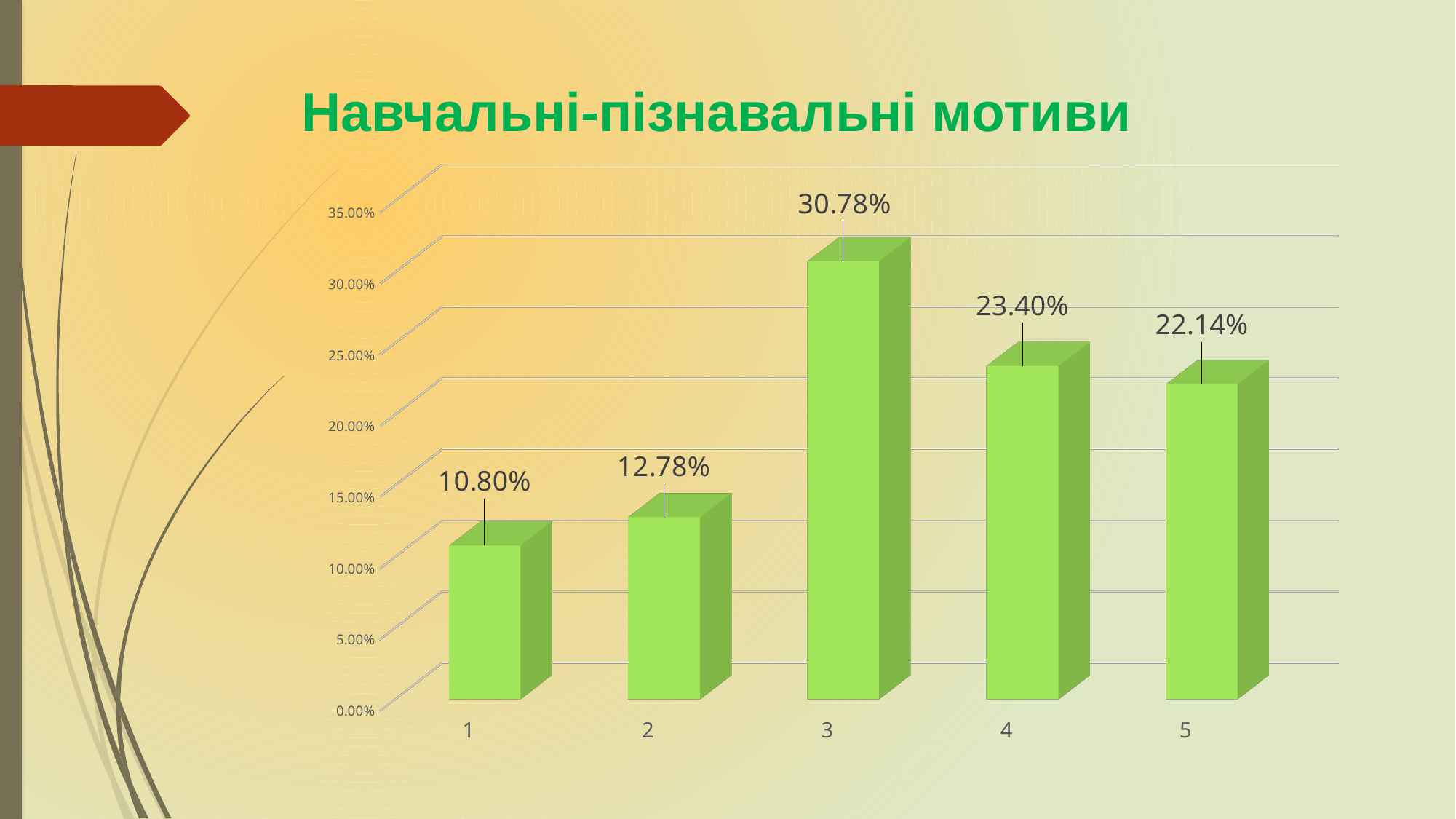
Which category has the lowest value? 1 What is the value for category 5? 22.14% Which category has the highest value? 3 What kind of chart is shown on the slide? bar chart Which is larger, the value for category 4 or category 5? 4 What is the title of the slide? Навчальні-пізнавальні мотиви What is the difference between the values for category 2 and category 1? 1.98% Is the value for category 2 greater or less than 15.00%? less What is the difference between the values for category 3 and category 4? 7.38% How many categories are shown on the x axis? 5 What is the value for category 1? 10.80% What is the value for category 3? 30.78%